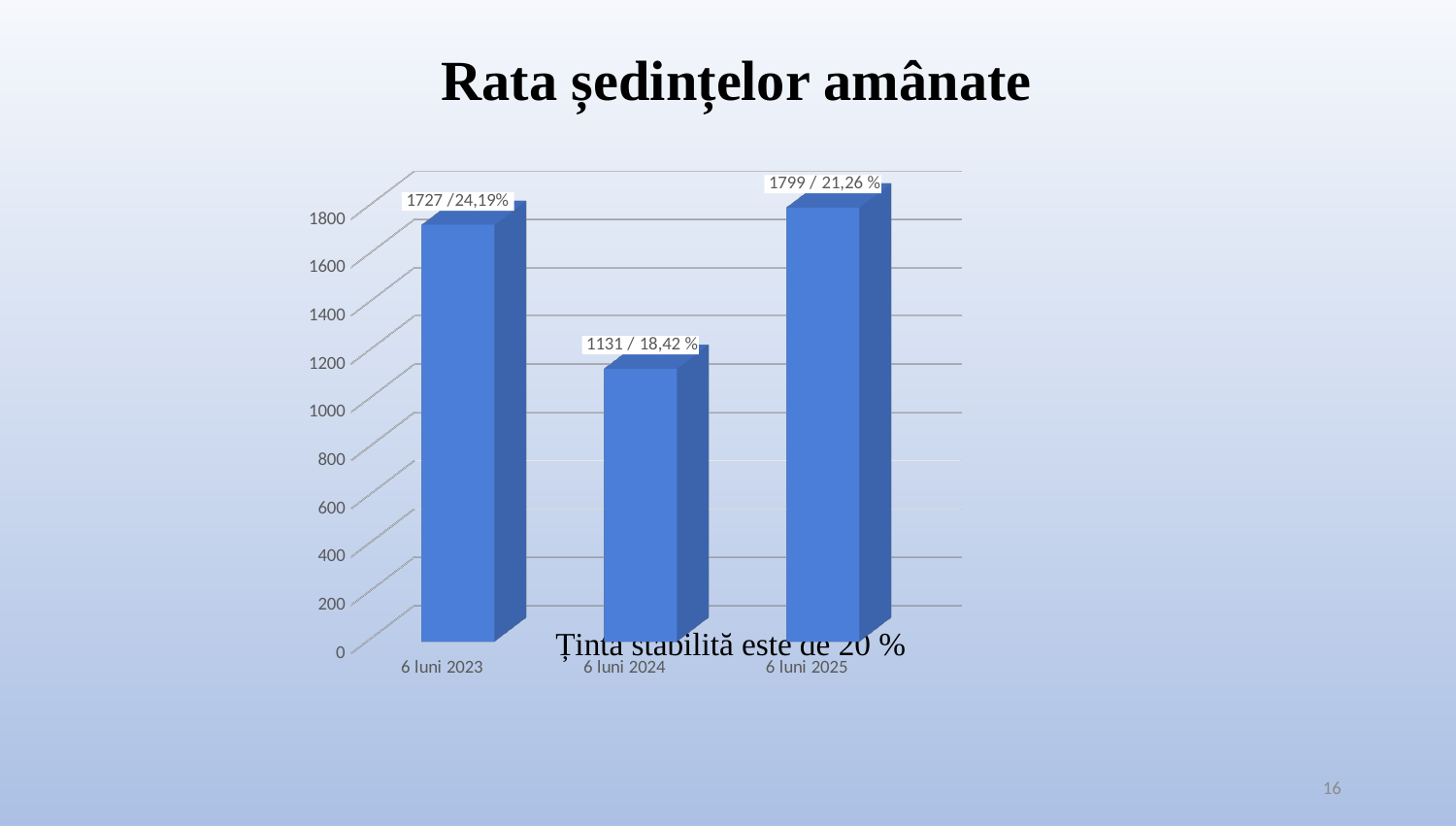
How many bars are shown in the chart? 3 Which period has the highest bar? 6 luni 2025 What is the data label shown on the bar for 6 luni 2025? 1799 / 21,26 % Is the value for 6 luni 2024 greater or less than 1200? less Which is larger, the count for 6 luni 2023 or the count for 6 luni 2024? 6 luni 2023 What is the data label shown on the bar for 6 luni 2023? 1727 /24,19% What is the data label shown on the bar for 6 luni 2024? 1131 / 18,42 % What kind of chart is shown on the slide? bar chart What is the title of the chart on the slide? Rata ședințelor amânate What is the difference between the count for 6 luni 2023 (1727) and the count for 6 luni 2024 (1131)? 596 What is the difference between the count for 6 luni 2025 (1799) and the count for 6 luni 2023 (1727)? 72 Which period has the lowest bar? 6 luni 2024